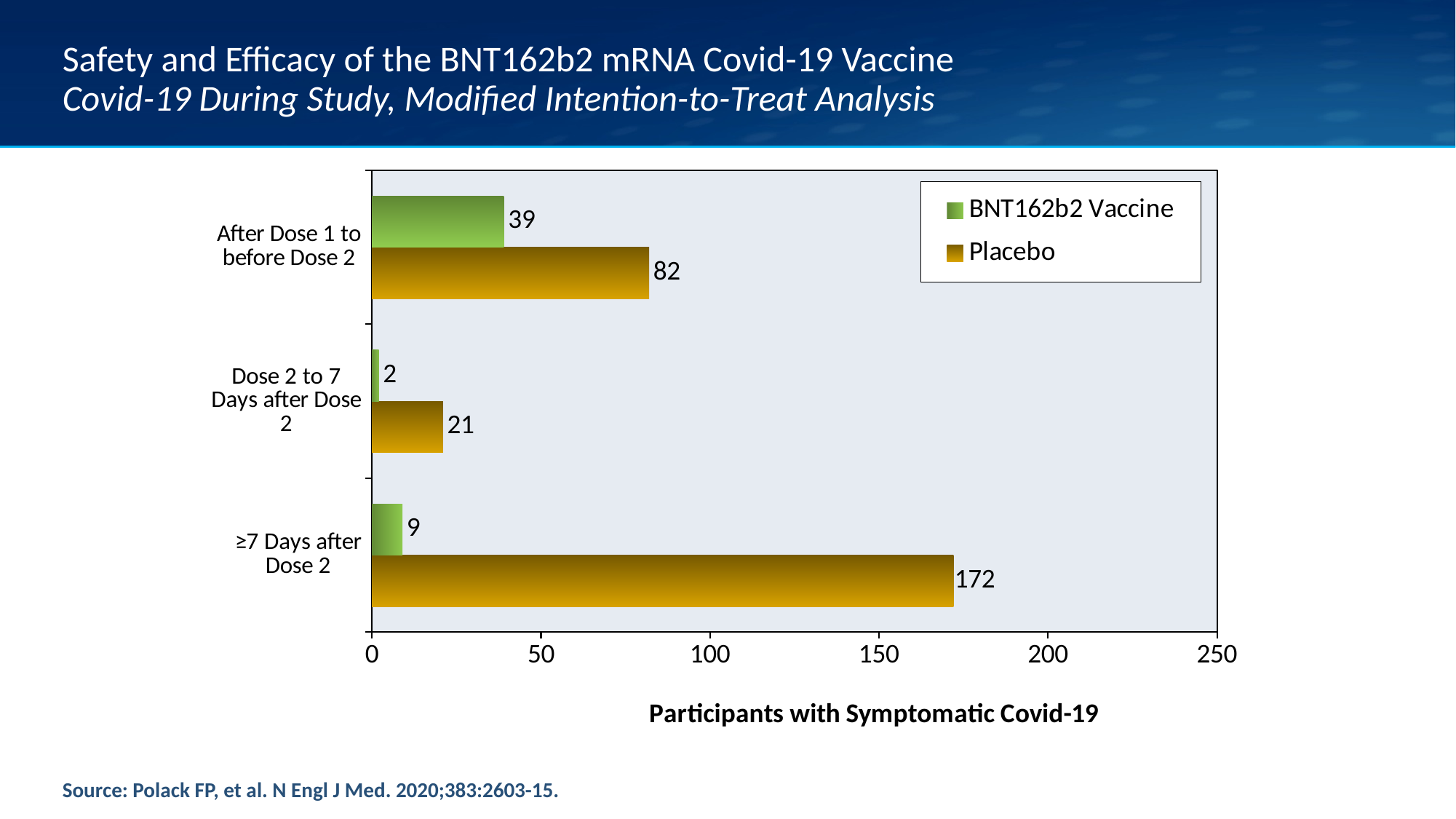
What is the number of participants with symptomatic Covid-19 in the Placebo group for ≥7 Days after Dose 2? 172 What kind of chart is shown on the slide? Bar chart Which period has the lowest BNT162b2 Vaccine value? Dose 2 to 7 Days after Dose 2 What is the value for the Placebo group in the Dose 2 to 7 Days after Dose 2 period? 21 What is the value for the BNT162b2 Vaccine group for ≥7 Days after Dose 2? 9 What is the difference between the Placebo and BNT162b2 Vaccine values for ≥7 Days after Dose 2? 163 How many time periods (categories) are shown on the chart? 3 Which is larger in the Dose 2 to 7 Days after Dose 2 period: the BNT162b2 Vaccine value or the Placebo value? Placebo Which period has the highest Placebo value? ≥7 Days after Dose 2 How many series does the legend list? 2 What is the value for the BNT162b2 Vaccine group in the After Dose 1 to before Dose 2 period? 39 What is the difference between the Placebo and BNT162b2 Vaccine values in the After Dose 1 to before Dose 2 period? 43